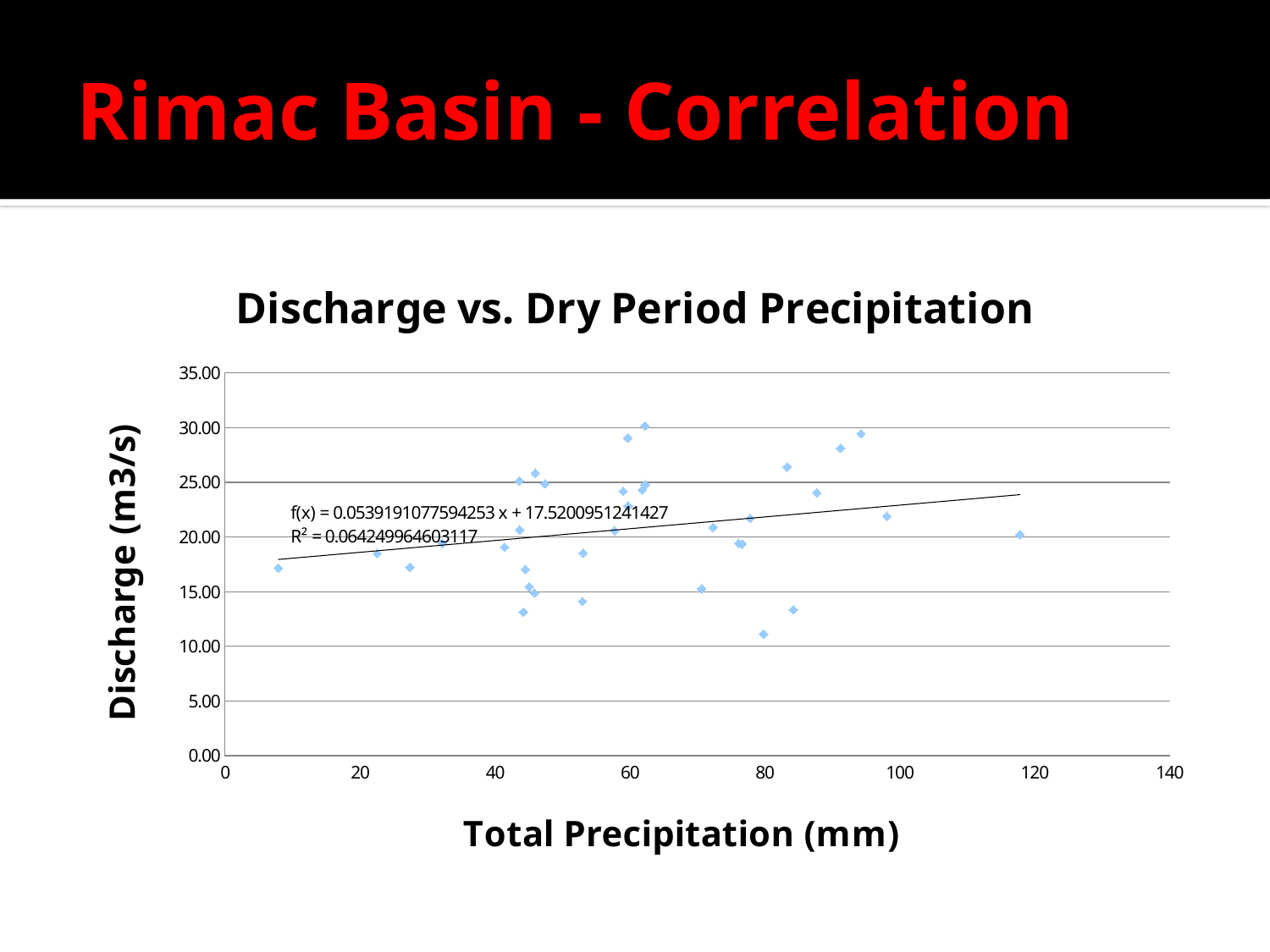
Is the highest plotted discharge value greater or less than 25.00? greater What is the highest tick value shown on the y axis? 35.00 Is the lowest plotted discharge value greater or less than 15.00? less What kind of chart is shown on the slide? scatter chart What R² value is printed on the chart? 0.064249964603117 What is the slope of the fitted trendline equation f(x) shown on the chart? 0.0539191077594253 What is the label of the x axis? Total Precipitation (mm) What is the intercept of the fitted trendline equation f(x) shown on the chart? 17.5200951241427 Does the fitted trendline rise or fall as Total Precipitation increases? rises What is the title of the chart? Discharge vs. Dry Period Precipitation What is the highest tick value shown on the x axis? 140